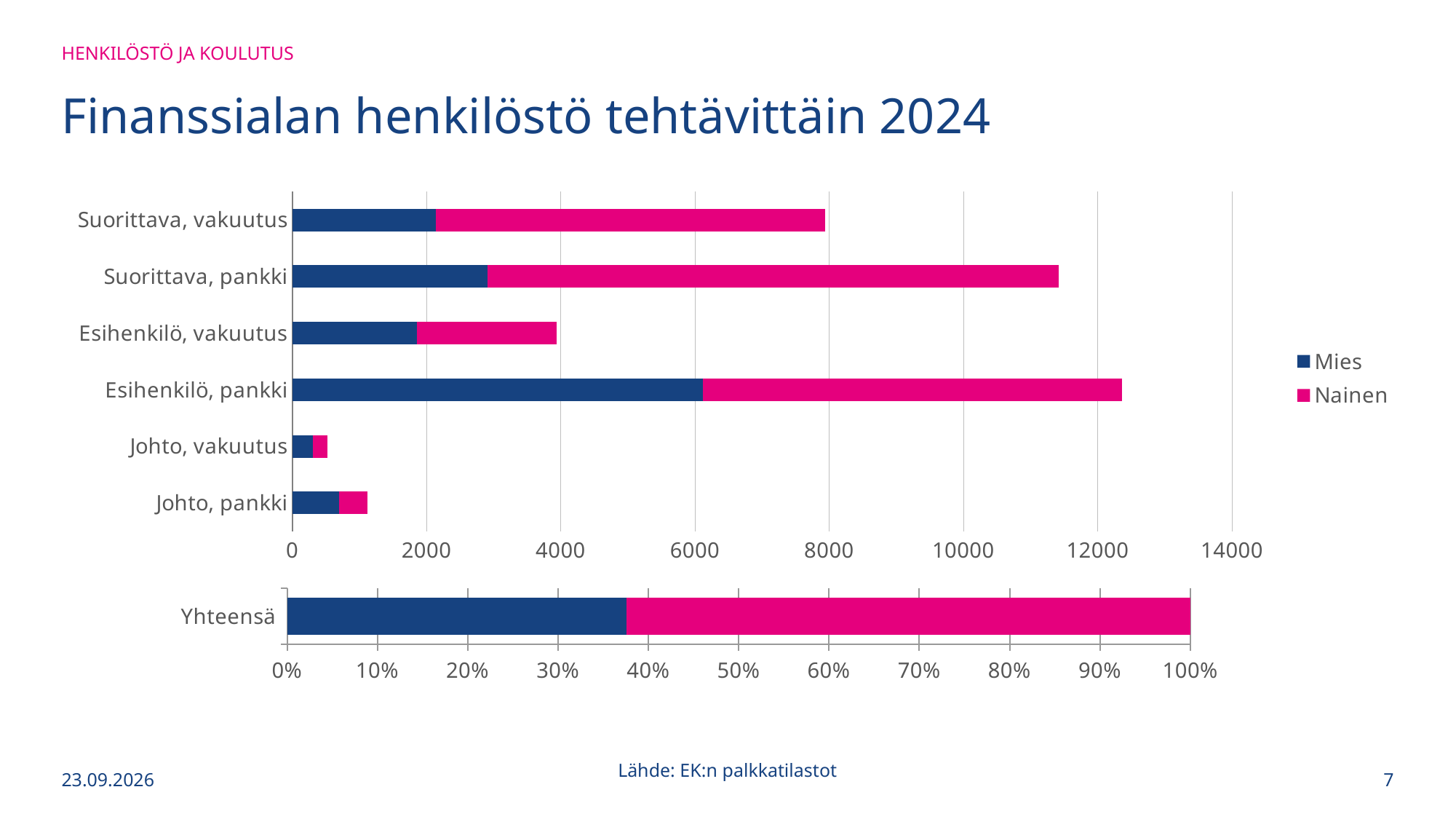
How many categories does the upper chart show? 6 In the upper chart, is the total bar for Suorittava, pankki greater or less than 10000? greater How many series does the legend list? 2 In the lower Yhteensä chart, is the Mies share greater or less than 50%? less In the upper chart, is the total bar for Esihenkilö, vakuutus greater or less than 6000? less What kind of chart is the upper chart on the slide? Stacked bar chart In the upper chart, which category has the shortest total bar? Johto, vakuutus In the lower Yhteensä chart, which series has the larger share: Mies or Nainen? Nainen In the upper chart, which category has the longest total bar? Esihenkilö, pankki In the upper chart, which has the longer total bar: Suorittava, vakuutus or Esihenkilö, vakuutus? Suorittava, vakuutus